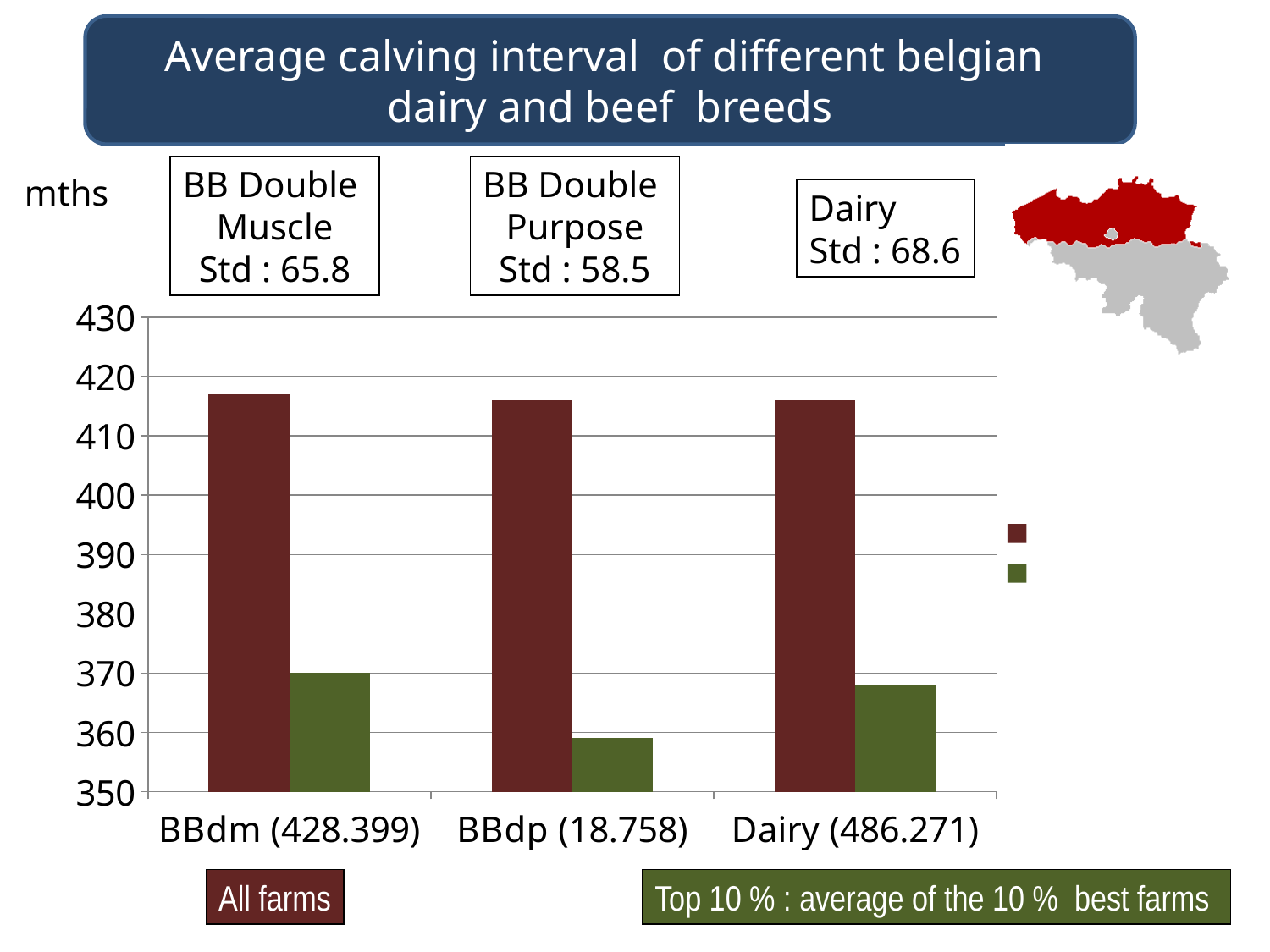
Is the Top 10 % value for BBdm (428.399) greater or less than 380? less Is the All farms value for Dairy (486.271) greater or less than 410? greater What kind of chart is shown on the slide? bar chart For BBdp (18.758), which is larger: the All farms value or the Top 10 % value? All farms Is the All farms value for BBdm (428.399) greater or less than 400? greater How many series does the chart's legend list? 2 Which colour represents the All farms series in the chart? dark red Which category has the lowest Top 10 % value? BBdp (18.758) What is the title of the chart on the slide? Average calving interval of different belgian dairy and beef breeds How many breed categories are shown on the x axis of the chart? 3